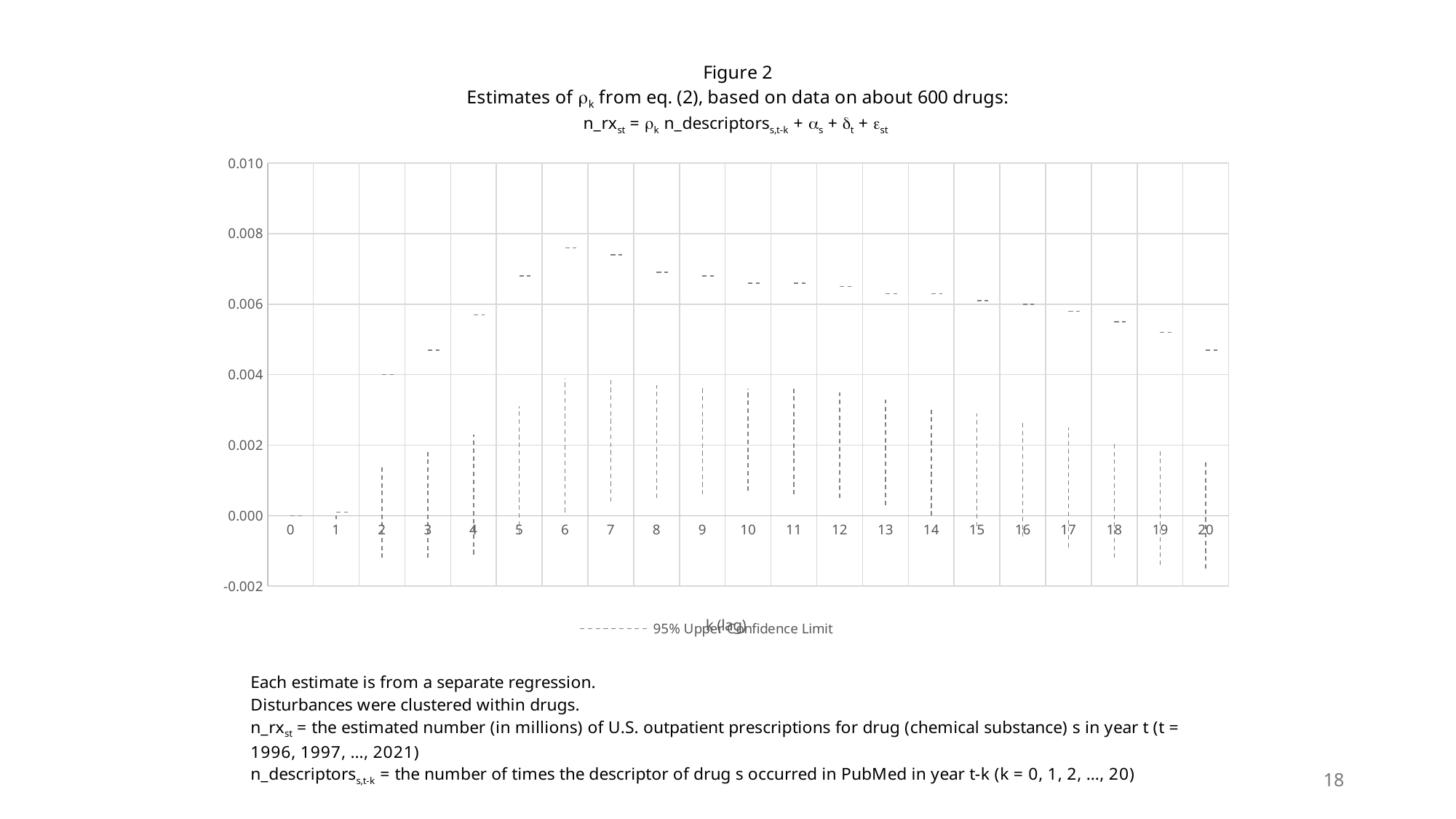
Is the 95% upper confidence limit at k = 18 greater or less than 0.004? greater At which lag k is the 95% upper confidence limit highest? 6 Which lag has the larger 95% upper confidence limit, k = 6 or k = 20? k = 6 What is the highest value labelled on the chart's y axis? 0.010 What series name appears in the chart legend? 95% Upper Confidence Limit How many series does the chart legend list? 1 Does the 95% upper confidence limit rise or fall as k increases from 6 to 20? fall Is the 95% upper confidence limit at k = 20 greater or less than 0.006? less Is the 95% upper confidence limit at k = 1 greater or less than 0.002? less At which lag k is the 95% upper confidence limit lowest? 0 How many lag values (k) are shown along the x axis of the chart? 21